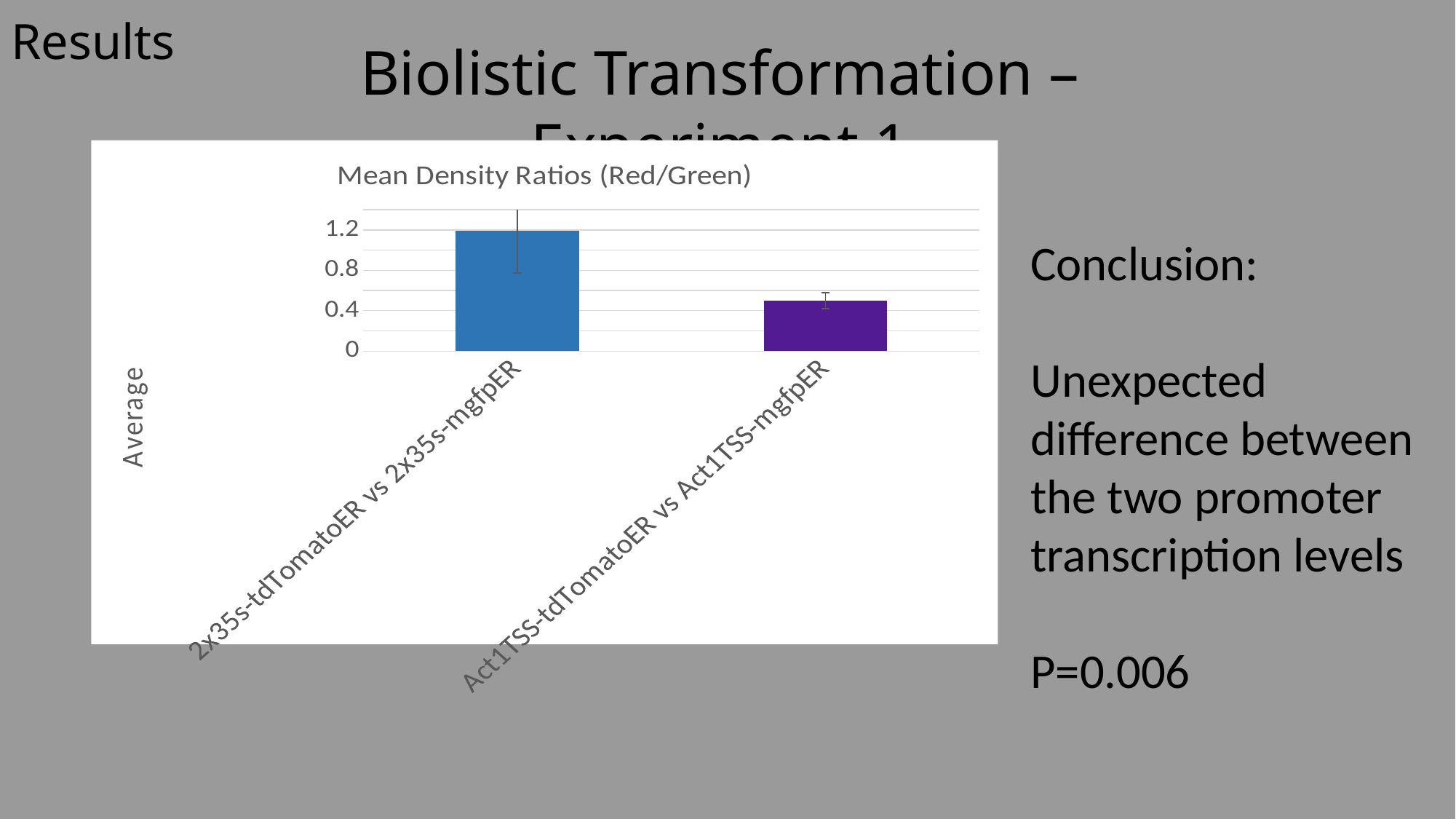
Is the value for Act1TSS-tdTomatoER vs Act1TSS-mgfpER greater or less than 0.8? less Which category has the highest mean density ratio? 2x35s-tdTomatoER vs 2x35s-mgfpER Is the value for 2x35s-tdTomatoER vs 2x35s-mgfpER greater or less than 0.8? greater Is the value for Act1TSS-tdTomatoER vs Act1TSS-mgfpER greater or less than 0.4? greater What is the label on the vertical axis of the chart? Average Which category has the lowest mean density ratio? Act1TSS-tdTomatoER vs Act1TSS-mgfpER What is the title of the chart? Mean Density Ratios (Red/Green) How many bars (categories) are plotted in the chart? 2 Which is larger, the value for 2x35s-tdTomatoER vs 2x35s-mgfpER or the value for Act1TSS-tdTomatoER vs Act1TSS-mgfpER? 2x35s-tdTomatoER vs 2x35s-mgfpER What kind of chart is shown on the slide? bar chart